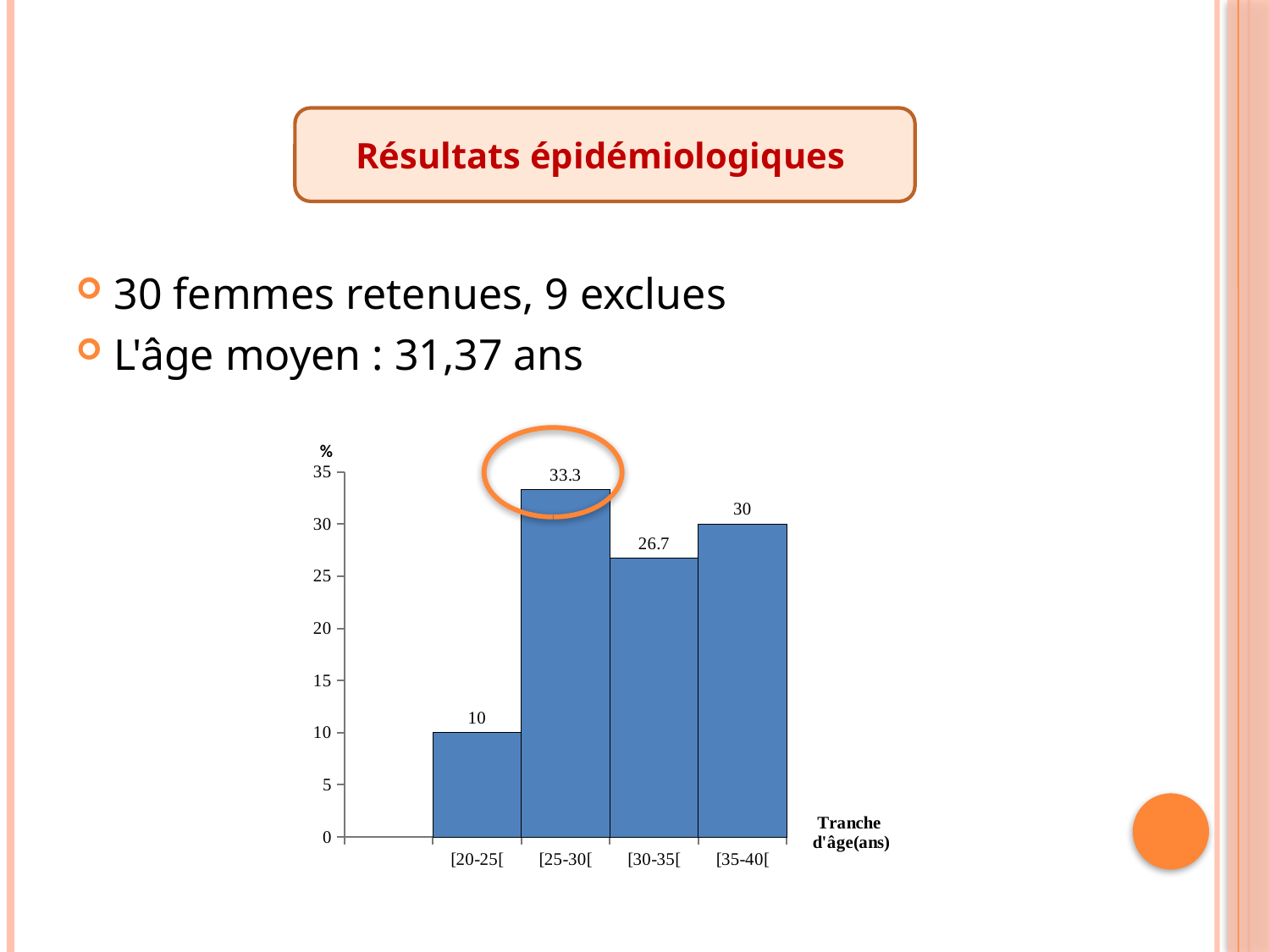
Which age group has the lowest value? [20-25[ Which age group has the highest value? [25-30[ What is the value for the [35-40[ age group? 30 What is the value for the [30-35[ age group? 26.7 What is the difference between the values for [25-30[ and [35-40[? 3.3 What is the label of the x axis of the chart? Tranche d'âge(ans) What is the value for the [20-25[ age group? 10 What kind of chart is shown on the slide? bar chart What is the value for the [25-30[ age group? 33.3 What is the difference between the values for [35-40[ and [20-25[? 20 How many age groups are shown on the chart? 4 Which is larger, the value for [30-35[ or the value for [35-40[? [35-40[